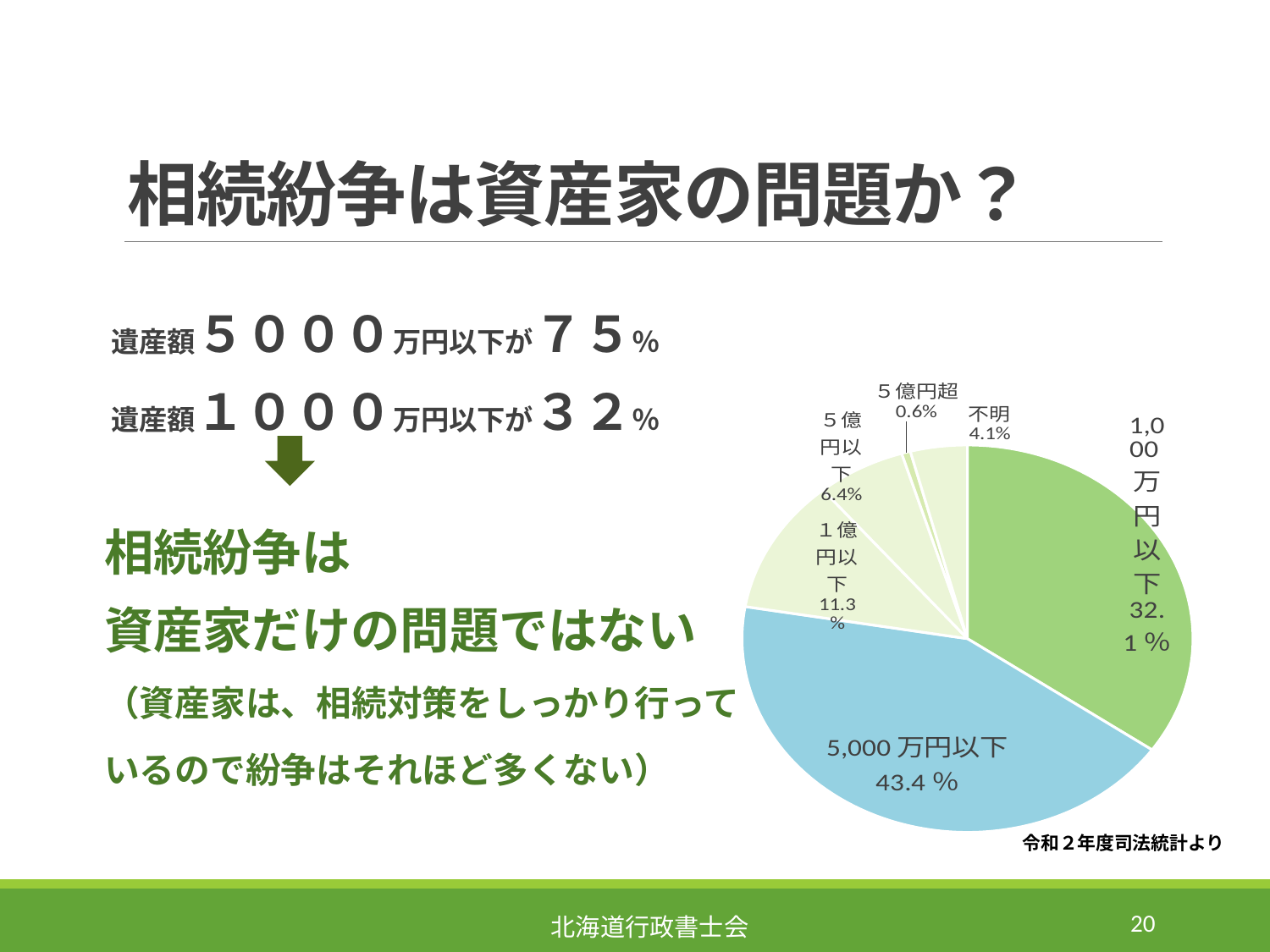
Which is larger, the 1億円以下 slice or the 5億円以下 slice? 1億円以下 What is the difference in percentage points between the 5,000万円以下 slice and the 1,000万円以下 slice? 11.3 How many slices does the pie chart have? 6 Which slice of the pie is the largest? 5,000万円以下 What percentage is shown for 不明? 4.1% What percentage is shown for 5億円以下? 6.4% What is the value shown for the 1,000万円以下 slice? 32.1% What is the combined share of the 1,000万円以下 and 5,000万円以下 slices? 75.5% What kind of chart is shown on the slide? pie chart What percentage is shown for 1億円以下? 11.3% Which slice of the pie is the smallest? 5億円超 What share of the pie does the 5,000万円以下 slice represent? 43.4%